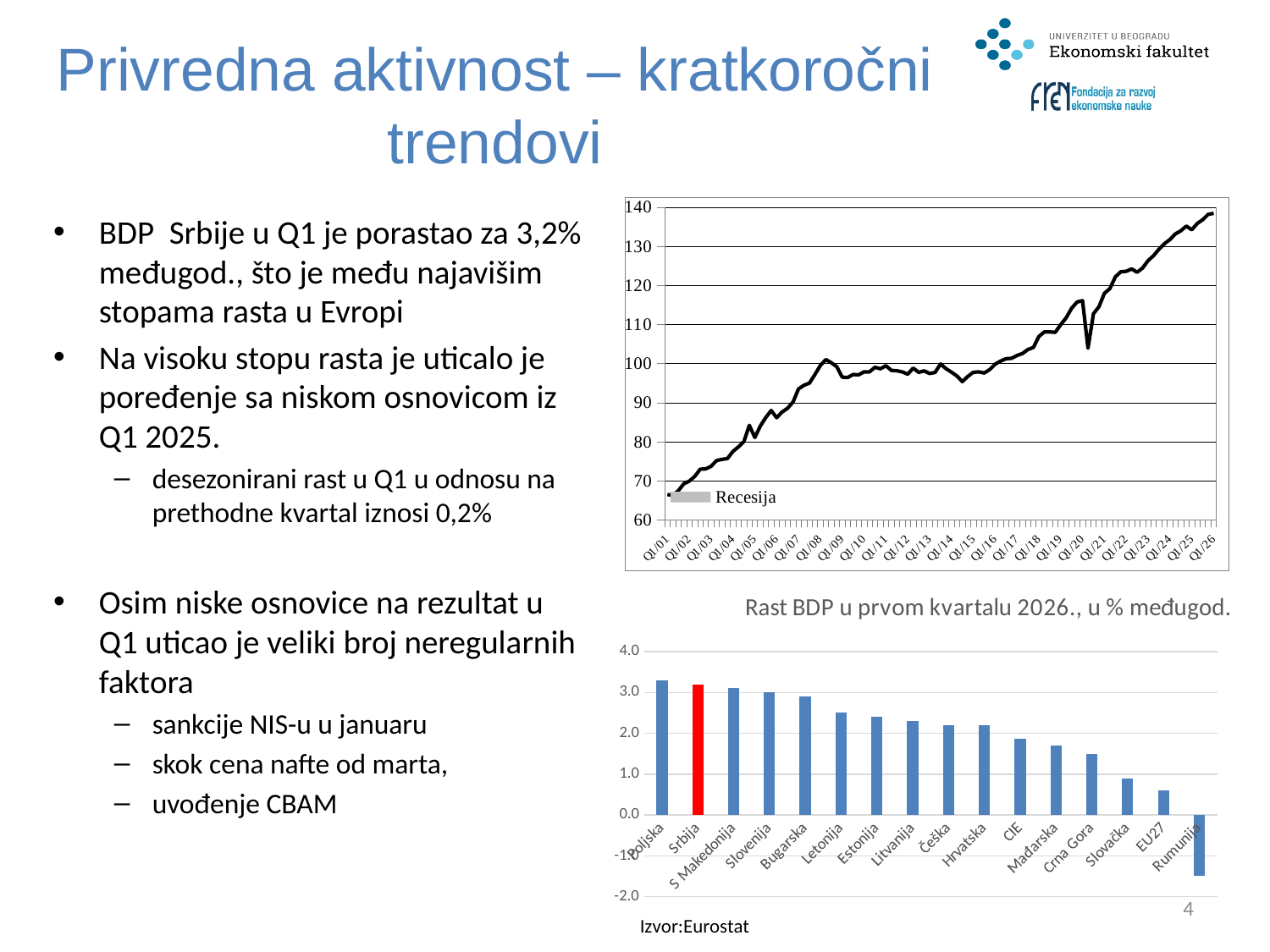
In the chart titled "Rast BDP u prvom kvartalu 2026., u % međugod.", which is larger, the value for Srbija or the value for EU27? Srbija In the chart titled "Rast BDP u prvom kvartalu 2026., u % međugod.", is the value for Poljska greater or less than 3.0? greater In the chart titled "Rast BDP u prvom kvartalu 2026., u % međugod.", how many countries/categories are shown? 16 In the top-right line chart, do the values generally rise or fall from Q1/01 to Q1/26? rise What kind of chart is the top-right chart with the "Recesija" legend? line chart In the chart titled "Rast BDP u prvom kvartalu 2026., u % međugod.", which category has the lowest value? Rumunija In the chart titled "Rast BDP u prvom kvartalu 2026., u % međugod.", is the value for Rumunija greater or less than 0.0? less In the chart titled "Rast BDP u prvom kvartalu 2026., u % međugod.", which is larger, the value for Slovenija or the value for Crna Gora? Slovenija In the chart titled "Rast BDP u prvom kvartalu 2026., u % međugod.", is the value for EU27 greater or less than 1.0? less What kind of chart is the chart titled "Rast BDP u prvom kvartalu 2026., u % međugod."? bar chart